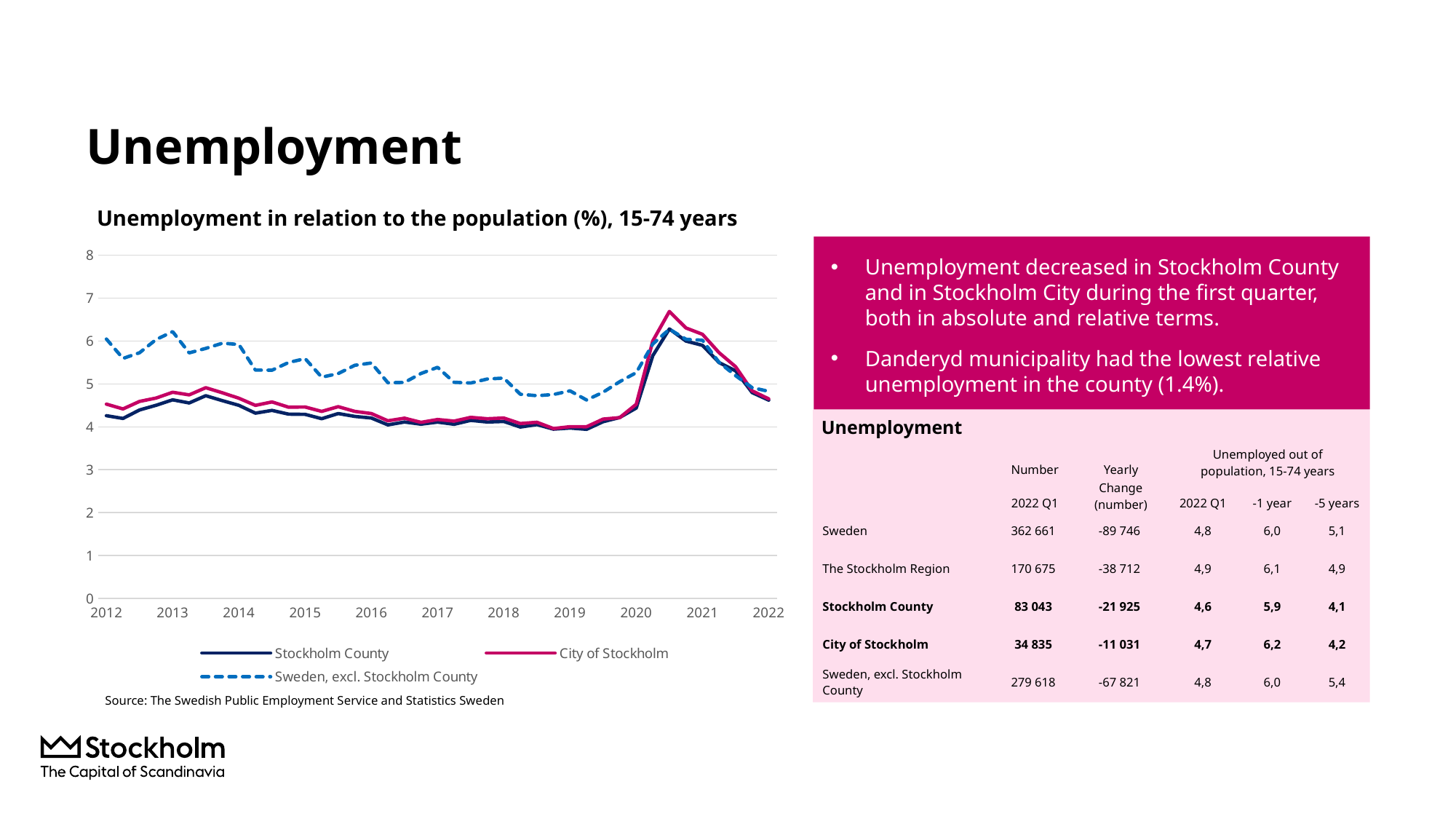
Which series is drawn with a dashed line? Sweden, excl. Stockholm County How many series does the chart legend list? 3 Is the peak value for City of Stockholm around 2020 greater or less than 6? greater Which series has the highest value in 2012? Sweden, excl. Stockholm County Does the Stockholm County series rise or fall between 2019 and 2020? rise What kind of chart is shown on the slide? Line chart In 2013, which is larger: Sweden, excl. Stockholm County or Stockholm County? Sweden, excl. Stockholm County Does the Sweden, excl. Stockholm County series rise or fall between 2013 and 2019? fall Is the value for Sweden, excl. Stockholm County in 2012 greater or less than 5? greater Is the value for Stockholm County in 2019 greater or less than 5? less How many year labels are shown on the x axis? 11 What is the title of the chart? Unemployment in relation to the population (%), 15-74 years